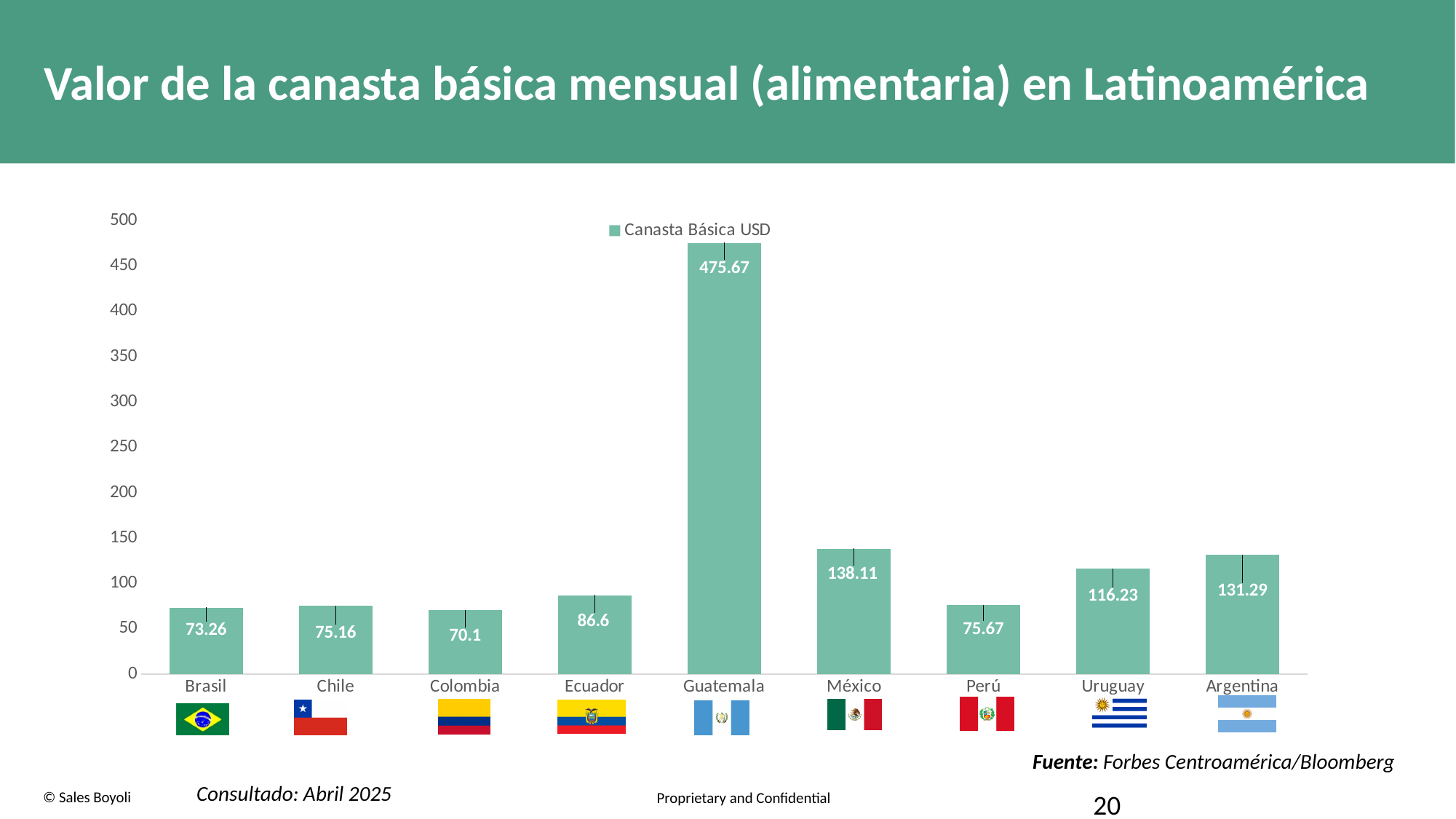
What is the difference between the values for Guatemala and México? 337.56 Is the value for Uruguay greater or less than 100? greater Which country has the lowest value? Colombia What is the value for México? 138.11 What series name does the legend show? Canasta Básica USD Which is larger, the value for Ecuador or the value for Perú? Ecuador What is the value for Colombia? 70.1 What is the value for Guatemala? 475.67 Which country has the highest value? Guatemala How many countries are shown on the chart? 9 What kind of chart is shown on the slide? bar chart What is the difference between the values for Argentina and Uruguay? 15.06